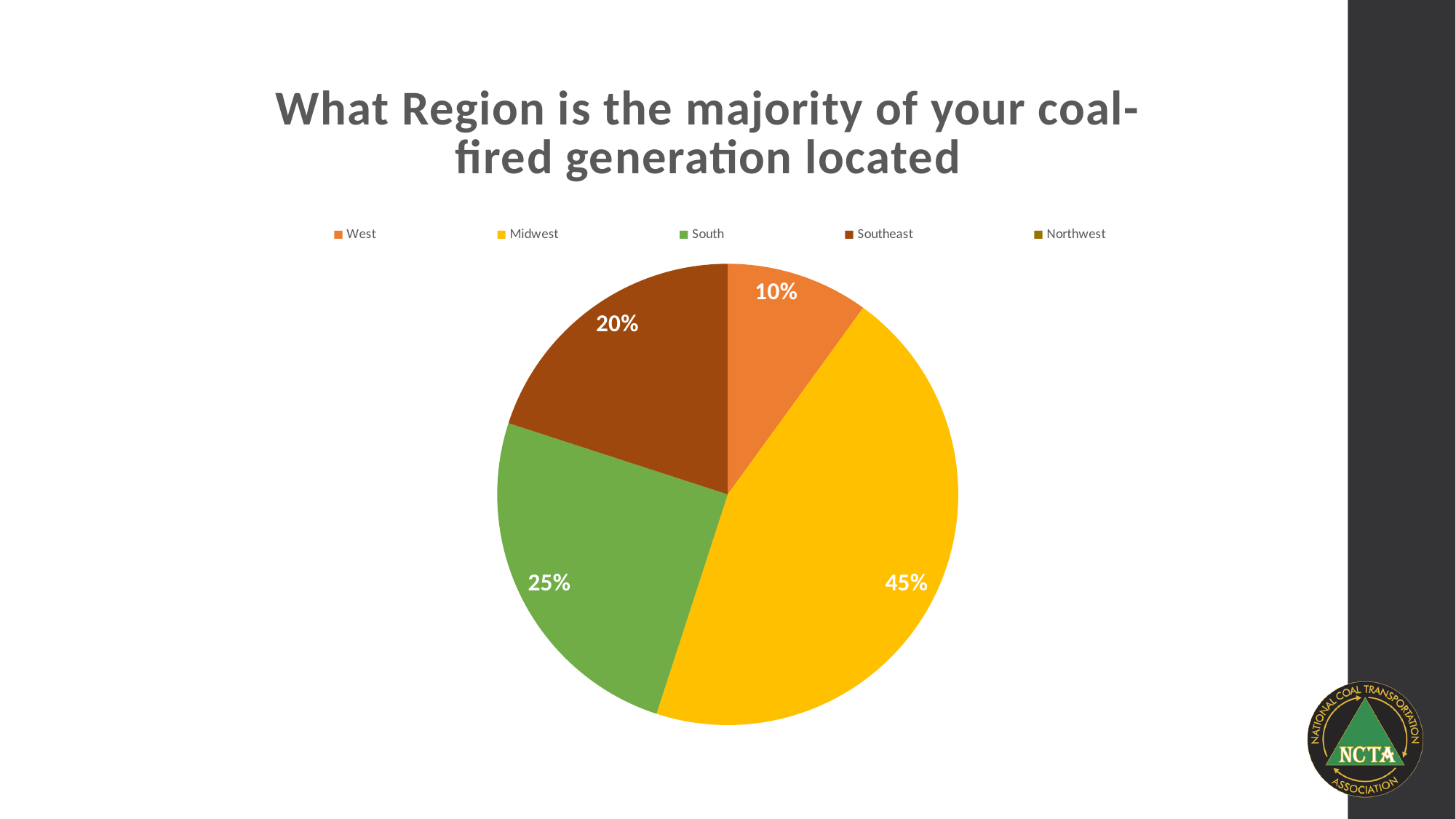
Which of the labelled slices is the smallest? West What share of the pie is labelled for Midwest? 45% How many percentage points larger is the Midwest slice than the South slice? 20 percentage points What is the title of the chart? What Region is the majority of your coal-fired generation located Which slice is larger, South or Southeast? South How many slices in the pie have a percentage label? 4 Which region has the largest slice of the pie? Midwest What share of the pie is labelled for Southeast? 20% How many regions are listed in the legend? 5 What type of chart is shown on the slide? Pie chart What share of the pie is labelled for South? 25% What share of the pie is labelled for West? 10%